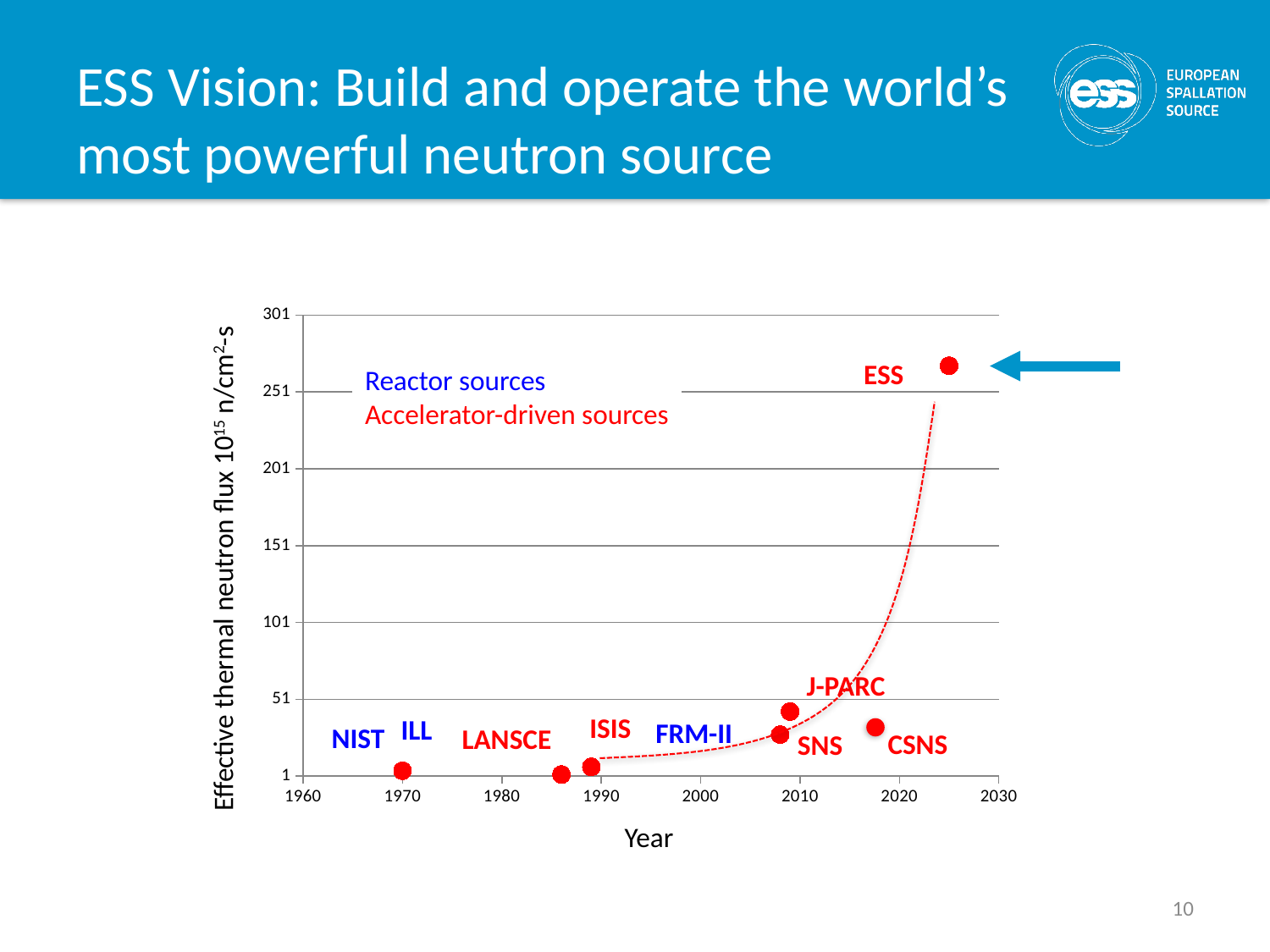
What is the title of the x axis? Year Is the value for CSNS greater or less than 101? less Which neutron source has the highest effective thermal neutron flux on the chart? ESS Is the value for J-PARC greater or less than 51? less Which has the higher effective thermal neutron flux, ESS or J-PARC? ESS Do the plotted flux values generally rise or fall as the year increases? rise Is the value for ESS greater or less than 251? greater What kind of chart is shown on the slide? scatter chart Which source is plotted furthest to the right (latest year) on the chart? ESS What colour is used for the labels of reactor sources? blue Which has the higher effective thermal neutron flux, J-PARC or SNS? J-PARC